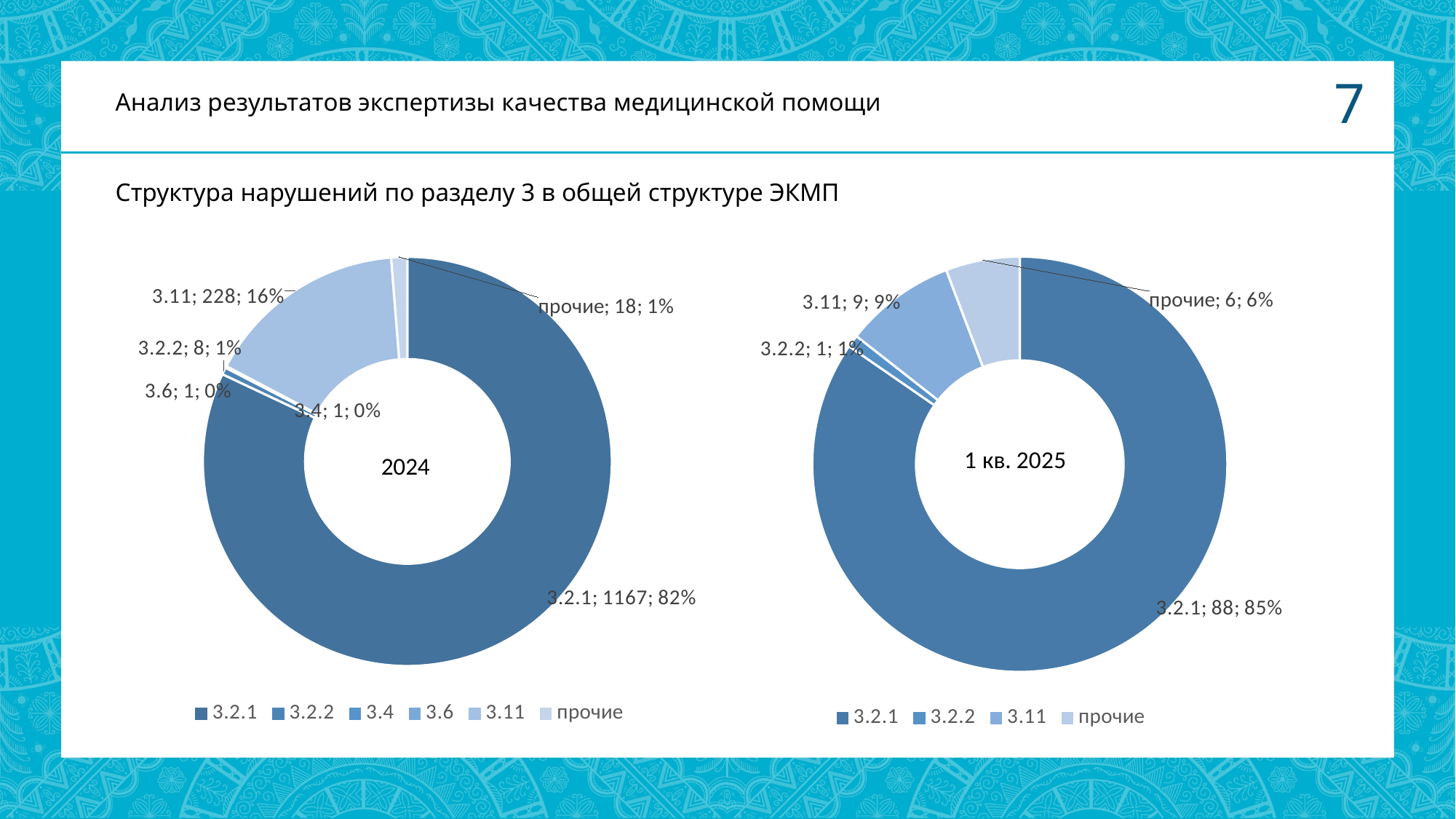
In the 2024 chart, what is the difference between the values for 3.11 and прочие? 210 In the 2024 chart, which category has the largest value? 3.2.1 In the 1 кв. 2025 chart, what share does 3.2.1 represent? 85% How many categories does the legend of the 2024 chart list? 6 What type of chart is used for the 2024 data? Doughnut (pie) chart In the 1 кв. 2025 chart, which category has the smallest value? 3.2.2 How many categories does the legend of the 1 кв. 2025 chart list? 4 In the 1 кв. 2025 chart, what is the value for прочие? 6 In the 1 кв. 2025 chart, what is the value for category 3.11? 9 In the 2024 chart, what share of the total does 3.11 represent? 16% In the 1 кв. 2025 chart, which is larger: the value for 3.11 or the value for прочие? 3.11 In the 2024 chart, what is the value for category 3.2.1? 1167